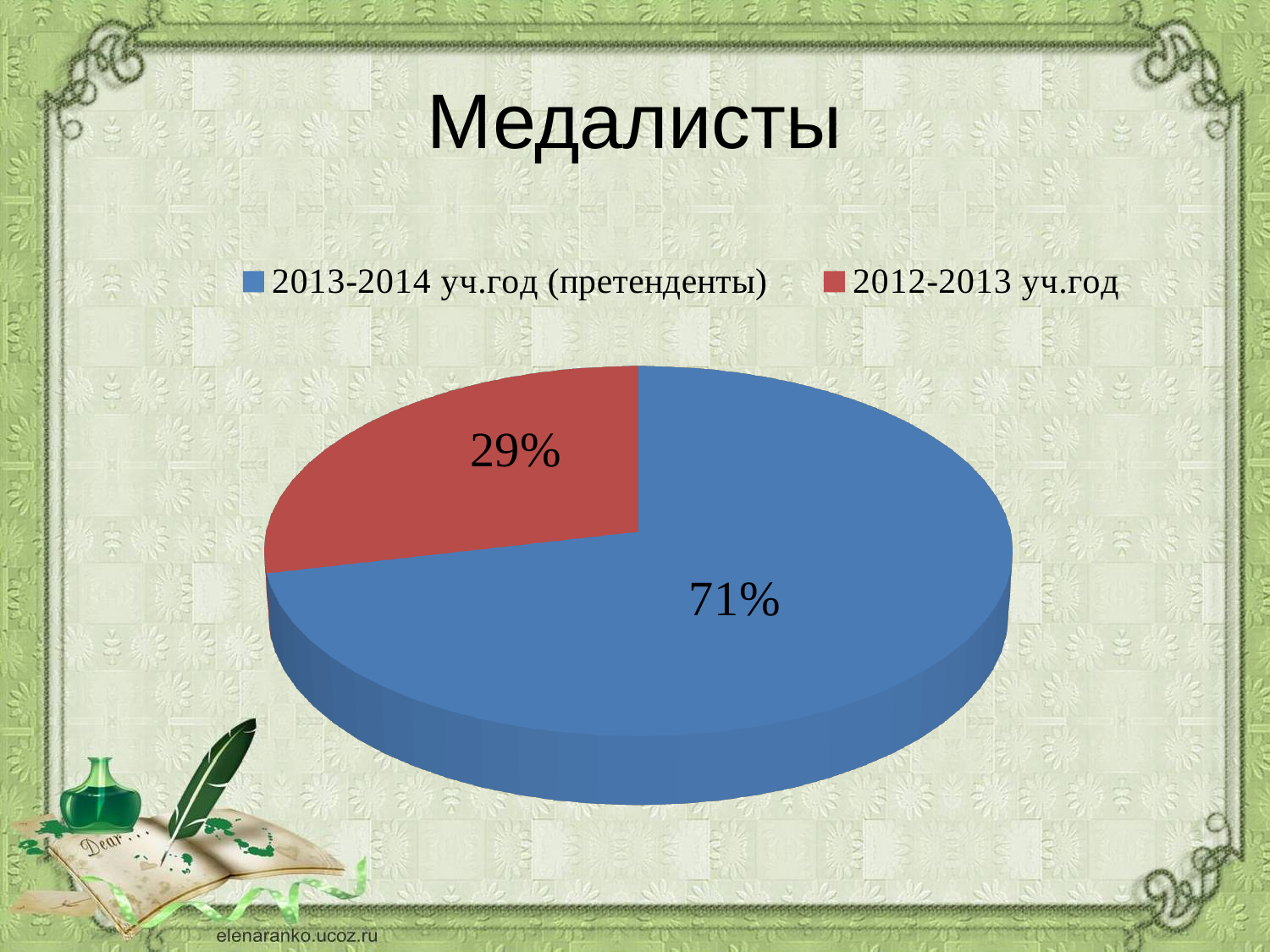
Which is larger: the 2012-2013 уч.год slice or the 2013-2014 уч.год (претенденты) slice? 2013-2014 уч.год (претенденты) How many slices does the pie chart have? 2 What share of the pie does the 2012-2013 уч.год slice take? 29% What share of the pie does the 2013-2014 уч.год (претенденты) slice take? 71% What is the difference in percentage points between the 2013-2014 уч.год (претенденты) slice and the 2012-2013 уч.год slice? 42 Which slice is the largest in the pie chart? 2013-2014 уч.год (претенденты) What kind of chart is shown on the slide? pie chart Which slice is the smallest in the pie chart? 2012-2013 уч.год What is the title of the chart? Медалисты How many entries does the legend list? 2 What colour is the 2012-2013 уч.год slice? red